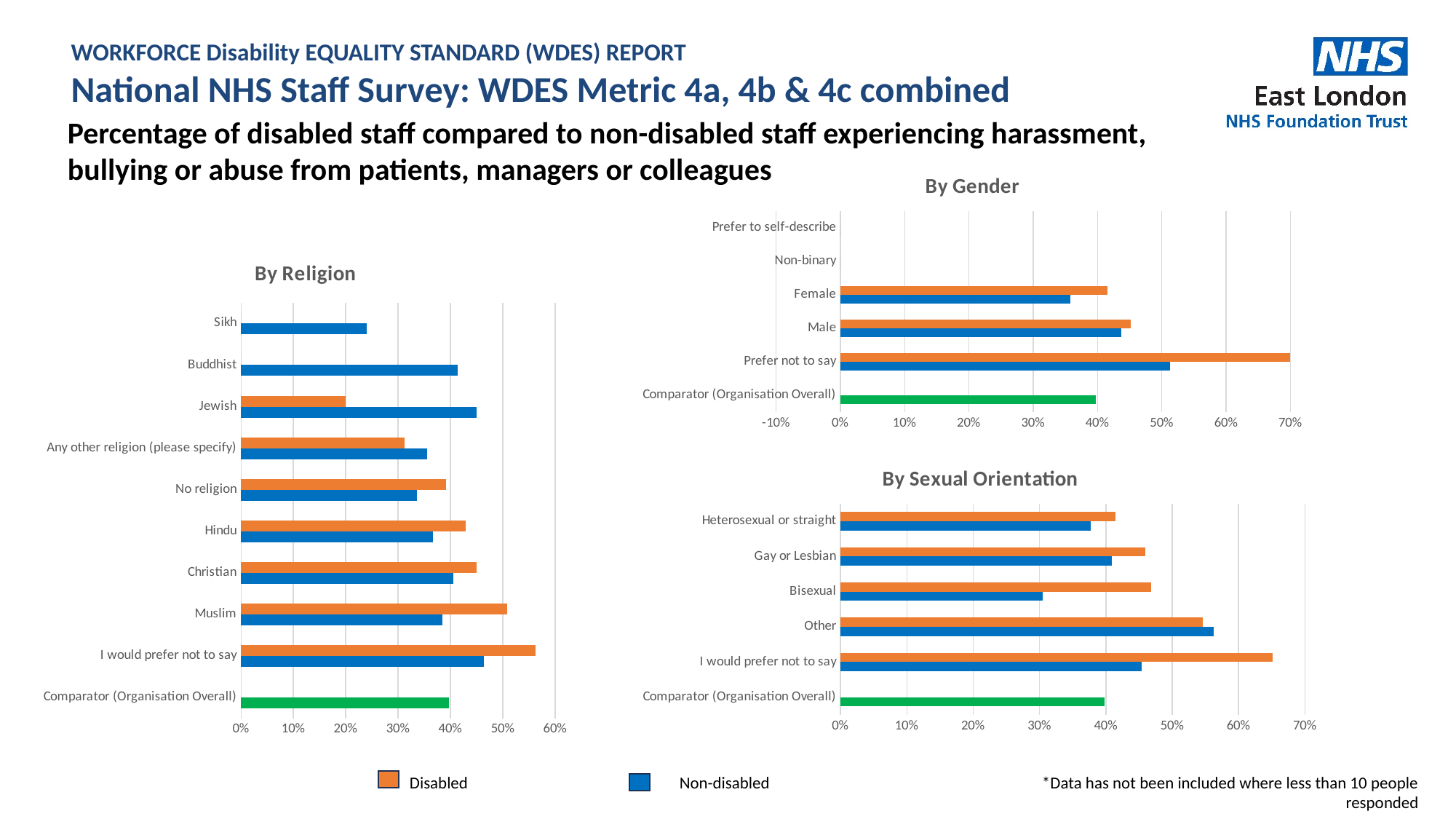
On the By Gender chart, which category has the highest Disabled value? Prefer not to say What colour is the Comparator (Organisation Overall) bar on each chart? Green How many categories are shown on the By Religion chart? 10 On the By Religion chart, which is larger for Jewish: the Disabled value or the Non-disabled value? Non-disabled How many series does the legend at the bottom of the slide list? 2 On the By Sexual Orientation chart, is the Non-disabled value for Bisexual greater or less than 40%? less What kind of chart is the By Religion chart? Bar chart On the By Religion chart, is the Disabled value for Jewish greater or less than 30%? less On the By Religion chart, which category has the lowest Non-disabled value? Sikh On the By Religion chart, which category has the highest Disabled value? I would prefer not to say On the By Sexual Orientation chart, which category has the highest Disabled value? I would prefer not to say On the By Gender chart, is the Disabled value for Prefer not to say greater or less than 60%? greater